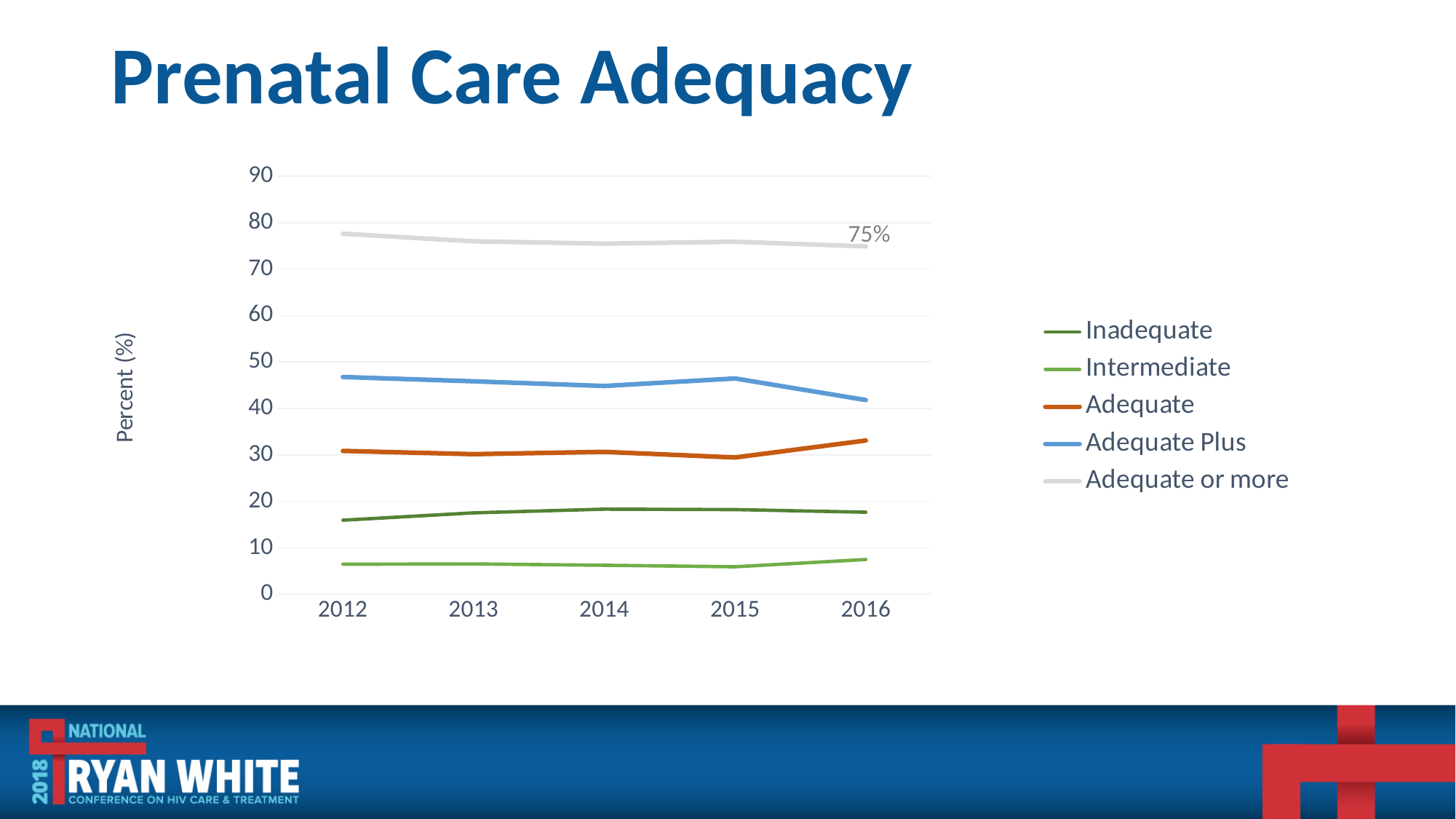
What is the labelled value for Adequate or more in 2016? 75% What is the title of the slide? Prenatal Care Adequacy Which series has the lowest values across all years? Intermediate Which series has the highest values across all years? Adequate or more How many series does the legend list? 5 Is the value for Inadequate in 2012 greater or less than 20? less Which is larger in 2016, Adequate Plus or Adequate? Adequate Plus How many years are shown on the x axis? 5 What type of chart is shown on the slide? line chart Is the value for Intermediate in 2016 greater or less than 10? less Does the Adequate Plus line rise or fall from 2015 to 2016? fall Is the value for Adequate Plus in 2016 greater or less than 40? greater